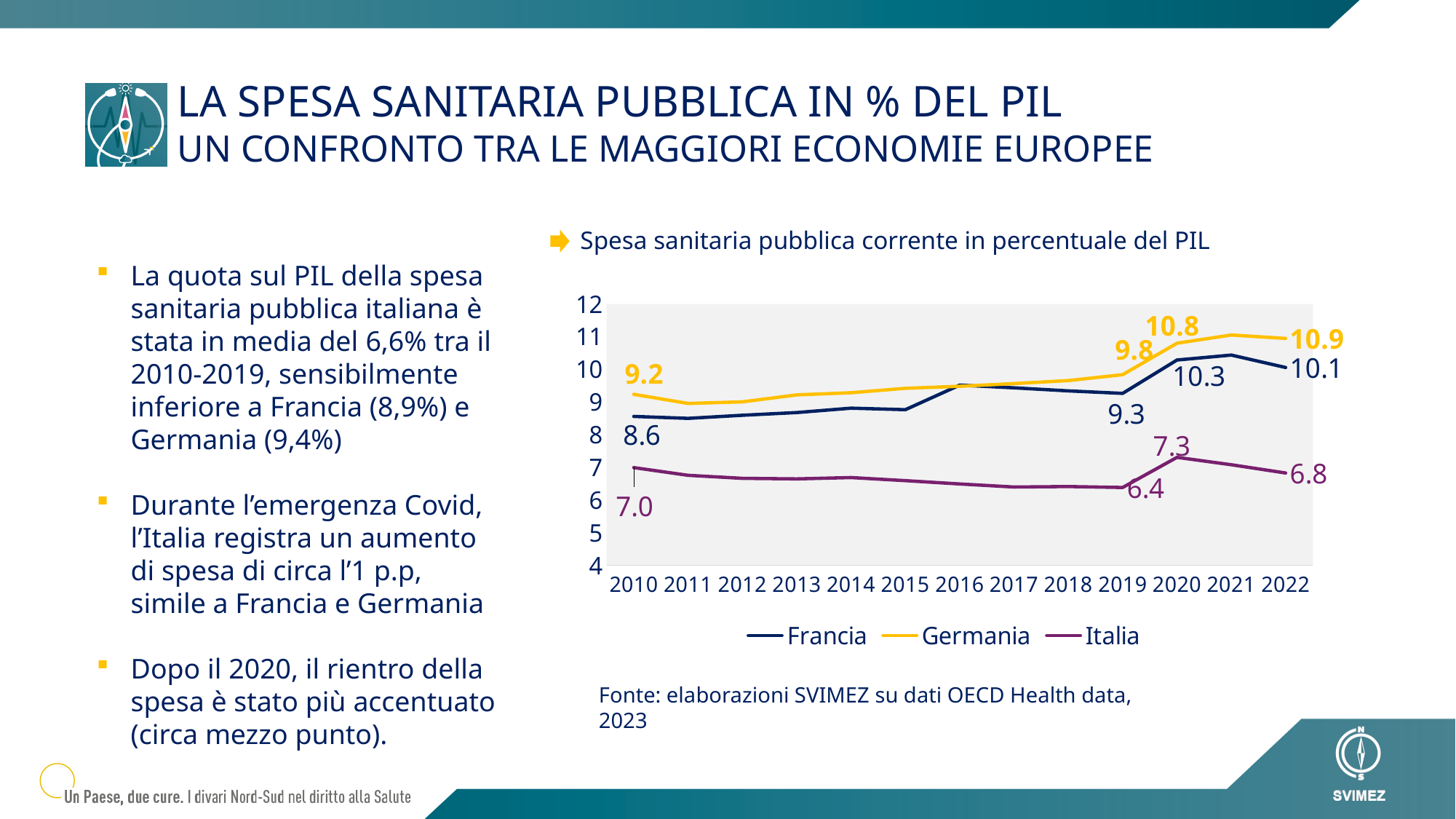
What is the value for Italia in 2019? 6.4 Which series has the highest value in 2020? Germania What is the value for Italia in 2020? 7.3 What is the value for Francia in 2010? 8.6 Which series has the lowest value in 2022? Italia What is the value for Germania in 2022? 10.9 Is the value for Francia in 2022 larger or smaller than the value for Germania in 2022? smaller How many years are shown on the x axis? 13 What kind of chart is shown on the slide? line chart Is the value for Italia in 2015 greater or less than 8? less What is the difference between Germania and Italia in 2022? 4.1 How many series does the legend list? 3